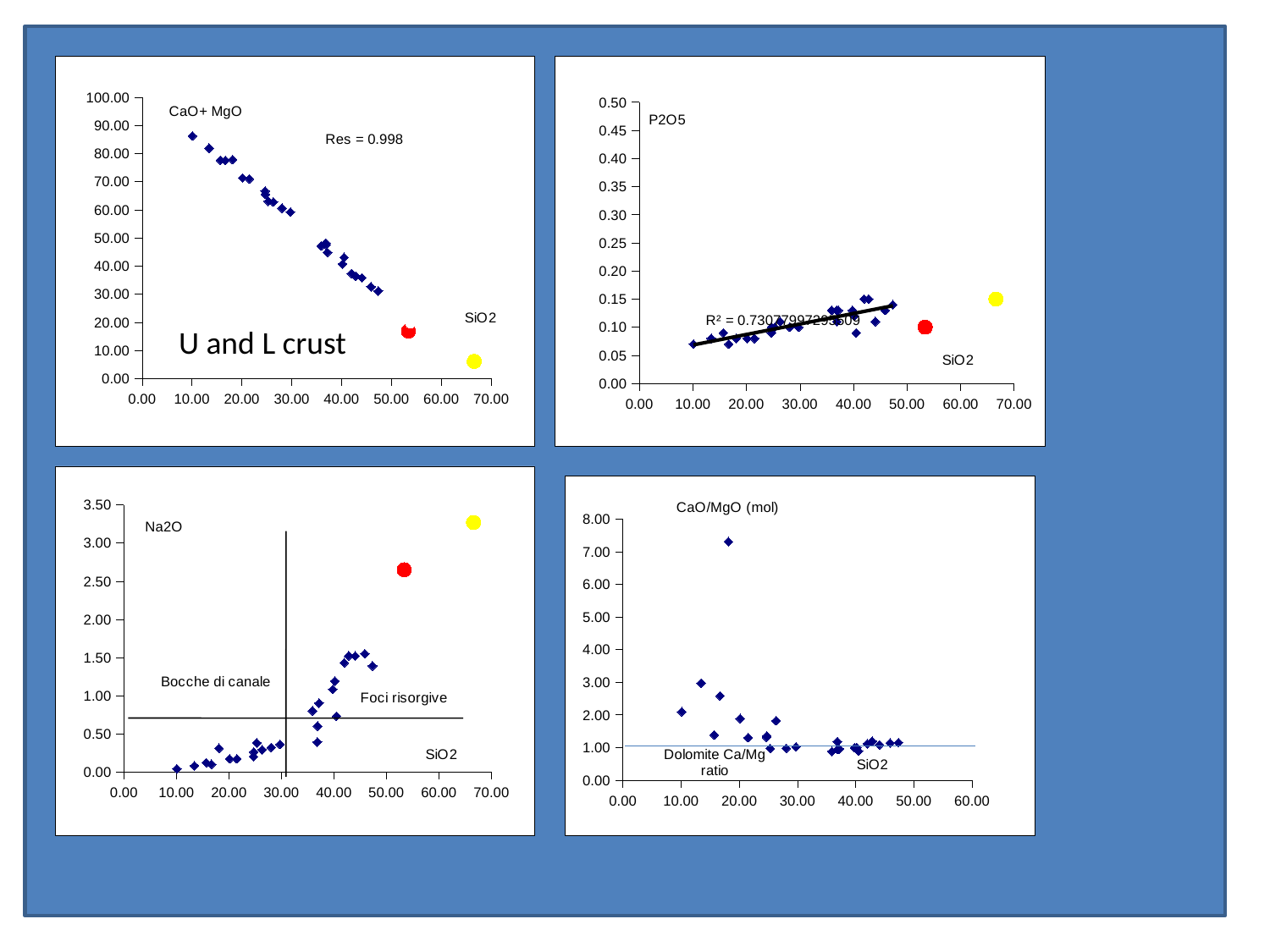
What are the two region labels printed on the bottom-left Na2O chart? Bocche di canale and Foci risorgive In the bottom-right chart, is the highest CaO/MgO (mol) value greater or less than 6.00? greater In the bottom-left chart, do the Na2O values rise or fall as SiO2 increases along the x axis? rise In the bottom-left chart, is the Na2O value of the yellow point greater or less than 3.00? greater In the bottom-right chart, do the CaO/MgO (mol) values rise or fall as SiO2 increases along the x axis? fall In the top-left chart, do the CaO+MgO values rise or fall as SiO2 increases along the x axis? fall In the top-right chart, is the P2O5 value of the yellow point greater or less than 0.10? greater How many charts are shown on the slide? 4 What kind of chart is the top-left chart (CaO+MgO vs SiO2)? scatter chart What Res value is printed on the top-left chart? Res = 0.998